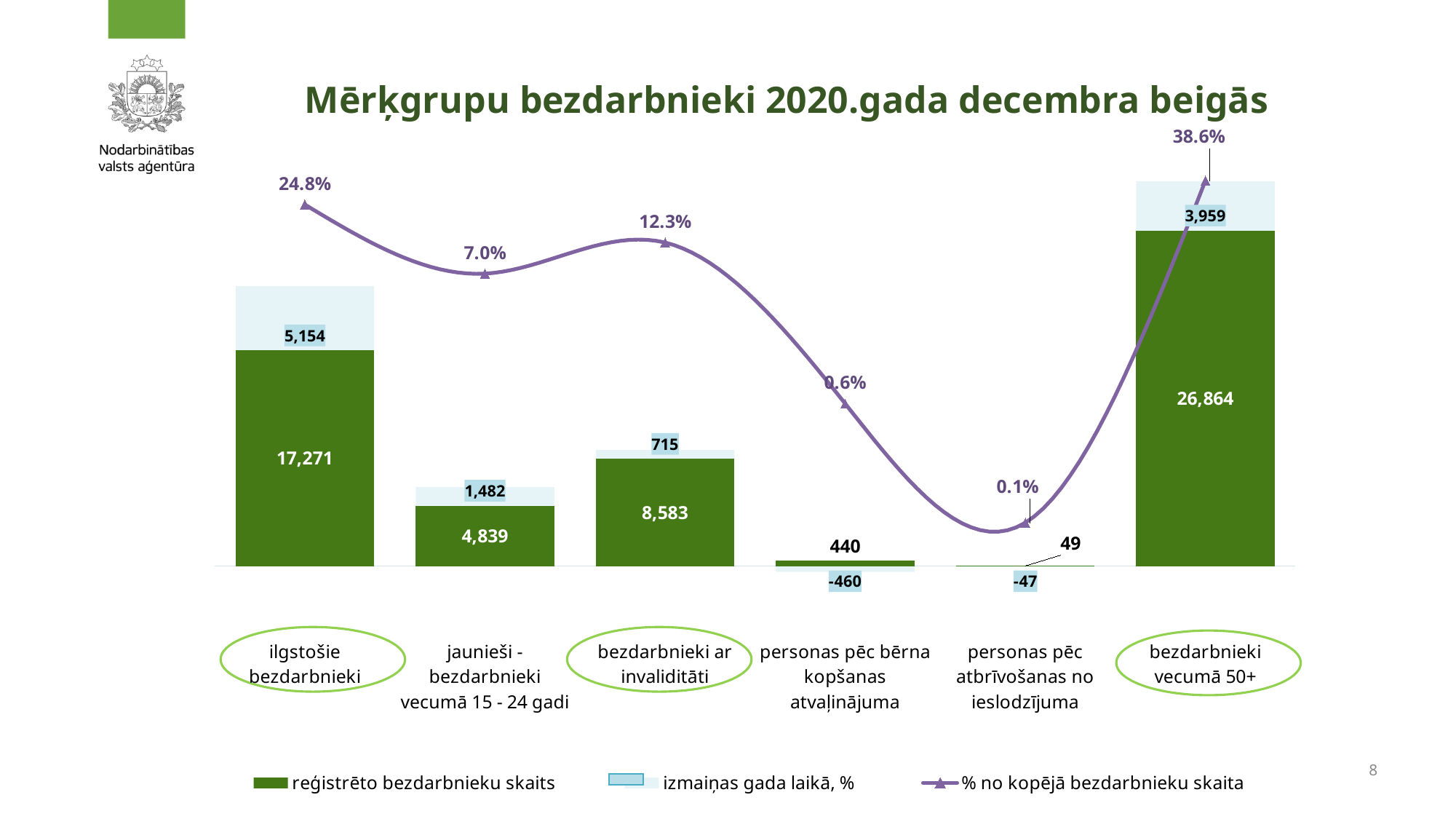
What share of total unemployed (% no kopējā bezdarbnieku skaita) do bezdarbnieki ar invaliditāti represent? 12.3% What is the difference between the registered unemployed counts for bezdarbnieki vecumā 50+ and ilgstošie bezdarbnieki? 9,593 Which has a larger registered unemployed count: bezdarbnieki ar invaliditāti or jaunieši - bezdarbnieki vecumā 15 - 24 gadi? bezdarbnieki ar invaliditāti What is the change during the year (izmaiņas gada laikā) for jaunieši - bezdarbnieki vecumā 15 - 24 gadi? 1,482 What kind of chart is this? Combination bar and line chart How many series does the legend list? 3 What is the registered unemployed count for ilgstošie bezdarbnieki? 17,271 What is the registered unemployed count (reģistrēto bezdarbnieku skaits) for bezdarbnieki vecumā 50+? 26,864 Which category has the highest registered unemployed count? bezdarbnieki vecumā 50+ Which category has the lowest share of total unemployed on the line series? personas pēc atbrīvošanas no ieslodzījuma How many categories are shown on the x axis? 6 What is the change during the year for personas pēc bērna kopšanas atvaļinājuma? -460